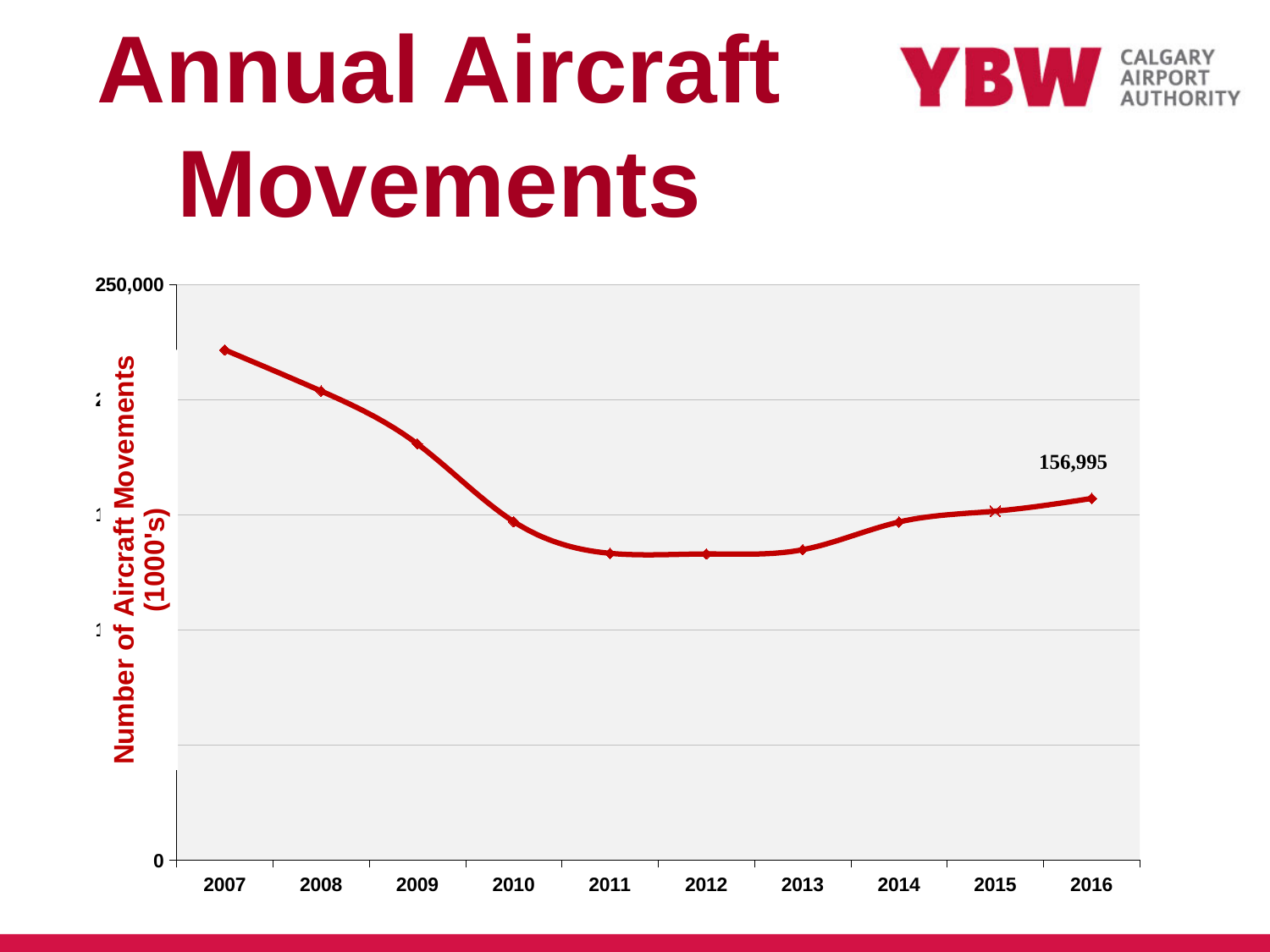
Is the value for 2011 greater or less than 150,000? less How many years are plotted on the chart? 10 Do the values rise or fall from 2007 to 2011? fall What kind of chart is shown on the slide? line chart Which is larger, the value for 2009 or the value for 2014? 2009 Which is larger, the value for 2007 or the value for 2016? 2007 Which year has the highest number of aircraft movements? 2007 Do the values rise or fall from 2013 to 2016? rise Is the value for 2013 greater or less than 150,000? less Is the value for 2007 greater or less than 200,000? greater What is the value for 2016? 156,995